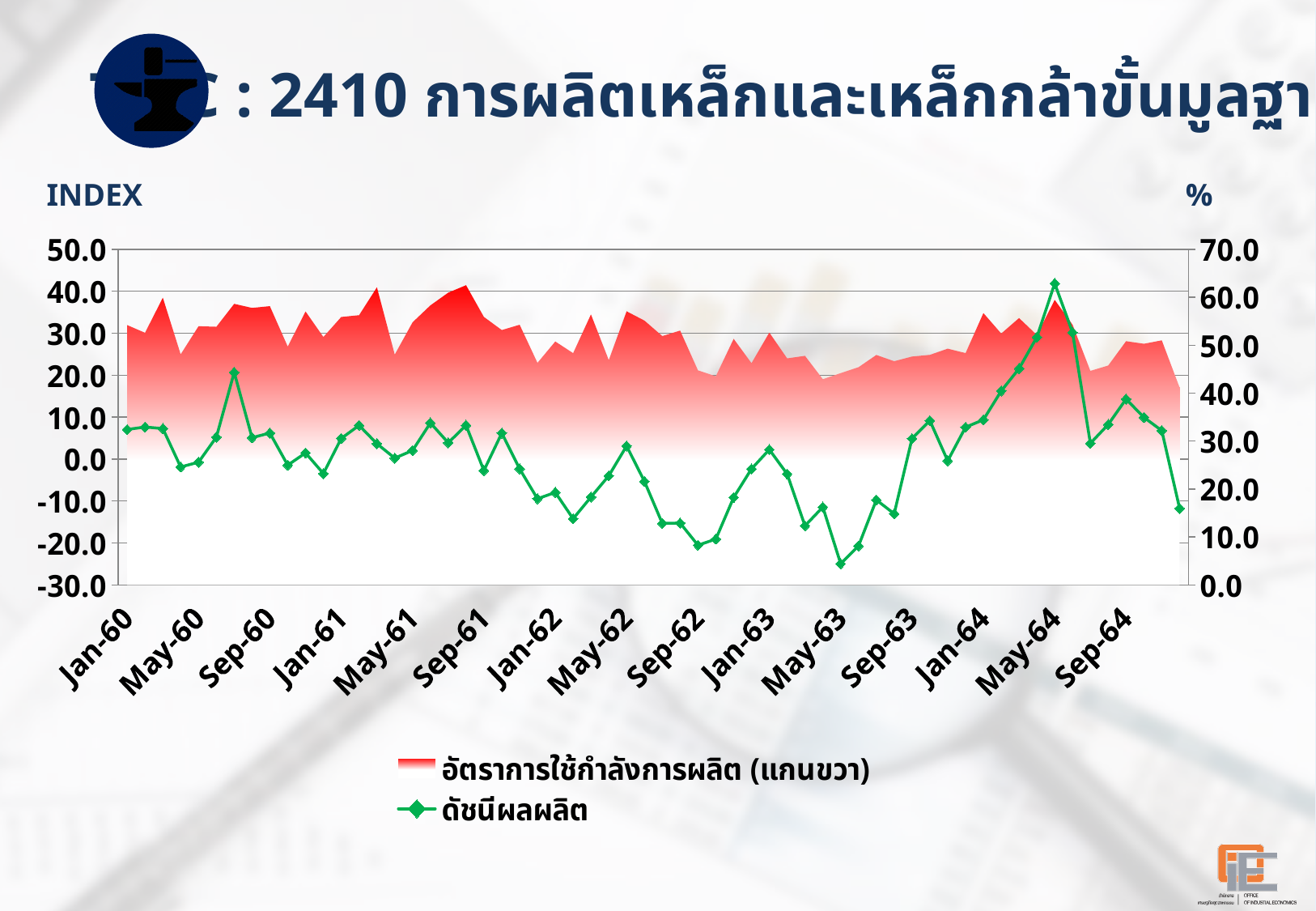
Is the ดัชนีผลผลิต value at May-64 greater or less than 30.0? greater Is the ดัชนีผลผลิต value at Sep-60 greater or less than 10.0? less Is the อัตราการใช้กำลังการผลิต value at Sep-62 greater or less than 50.0? less What is the label of the left vertical axis? INDEX What kind of chart is shown on the slide? A combination chart with a filled area series and a line series At which month does the green ดัชนีผลผลิต line reach its highest value? May-64 How many series does the legend list? 2 Does the ดัชนีผลผลิต line rise or fall between Sep-63 and May-64? rise At which month does the green ดัชนีผลผลิต line reach its lowest value? May-63 Which series is plotted on the right axis according to the legend? อัตราการใช้กำลังการผลิต (แกนขวา)